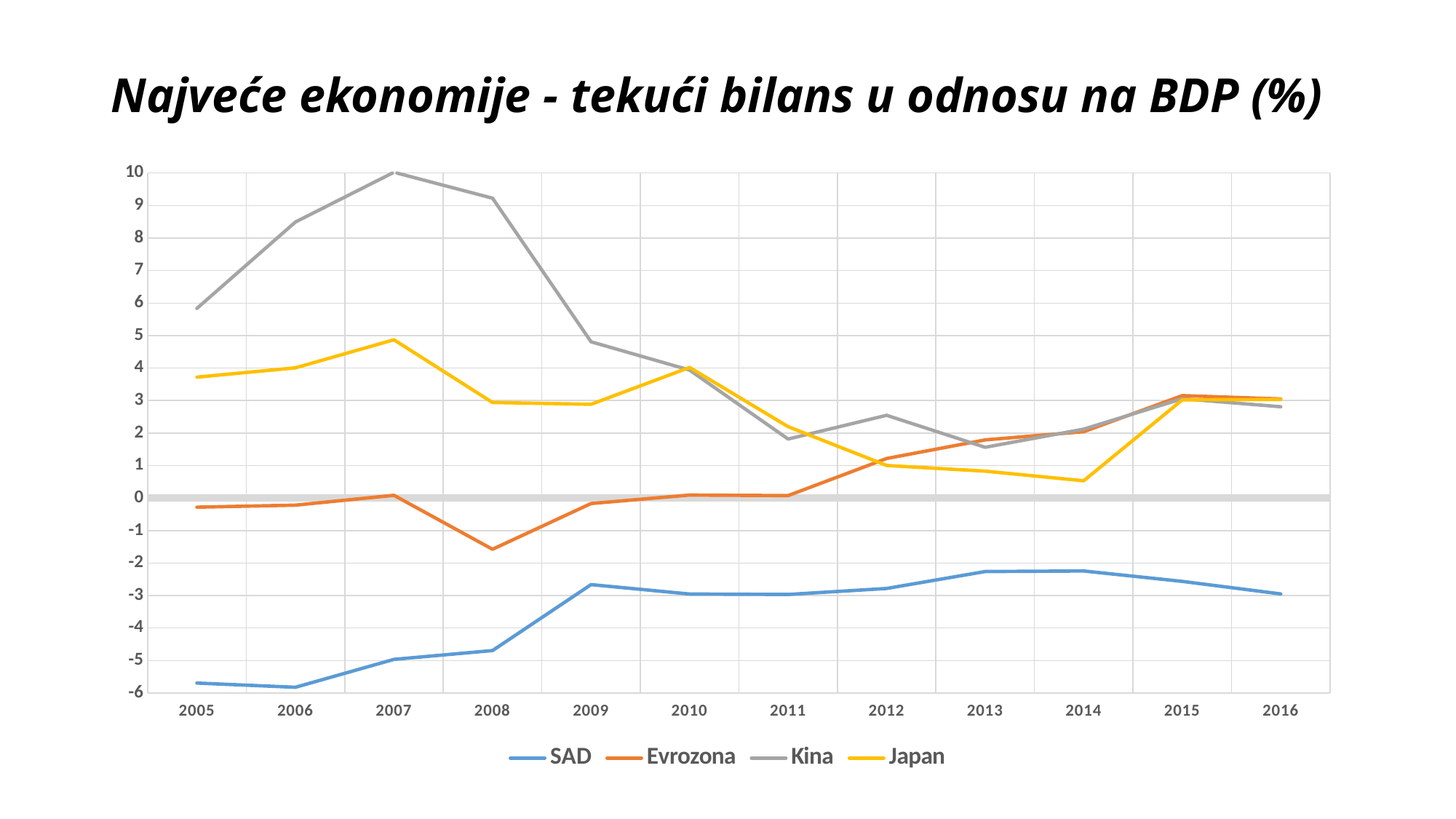
How many series does the legend list? 4 Which series has the lowest value in 2016? SAD Which is larger in 2012, the value for Kina or the value for Japan? Kina Is the value for SAD in 2005 greater or less than -5? less Is the value for Japan in 2007 greater or less than 4? greater How many years are shown on the x axis? 12 Does the value for Kina rise or fall from 2007 to 2011? fall What is the title of the chart? Najveće ekonomije - tekući bilans u odnosu na BDP (%) Is the value for Evrozona in 2008 greater or less than -1? less Which series has the highest value in 2007? Kina What kind of chart is shown on the slide? line chart